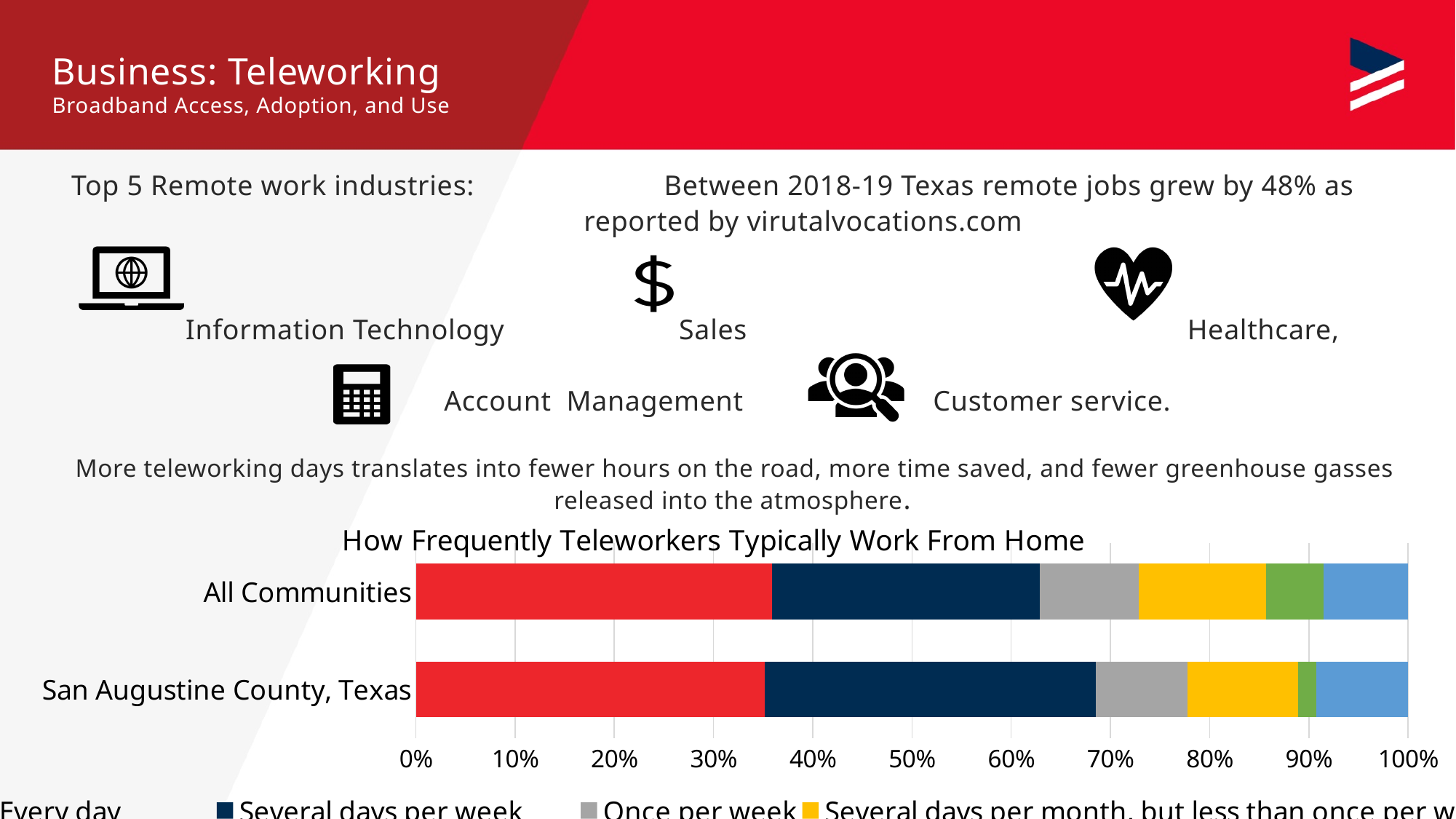
How many communities (categories) are plotted in the "How Frequently Teleworkers Typically Work From Home" chart? 2 In the "How Frequently Teleworkers Typically Work From Home" chart, which frequency category makes up the largest share for All Communities? Every day In the "How Frequently Teleworkers Typically Work From Home" chart, is the "Every day" share for All Communities greater or less than 30%? greater In the "How Frequently Teleworkers Typically Work From Home" chart, is the combined share of "Every day" and "Several days per week" for San Augustine County, Texas greater or less than 60%? greater What kind of chart is "How Frequently Teleworkers Typically Work From Home"? Stacked bar chart In the "How Frequently Teleworkers Typically Work From Home" chart, is the "Every day" share for San Augustine County, Texas greater or less than 30%? greater In the "How Frequently Teleworkers Typically Work From Home" chart, what colour represents "Every day"? Red What is the maximum value shown on the x axis of the "How Frequently Teleworkers Typically Work From Home" chart? 100% What is the title of the chart at the bottom of the slide? How Frequently Teleworkers Typically Work From Home In the "How Frequently Teleworkers Typically Work From Home" chart, which community has the larger green segment? All Communities In the "How Frequently Teleworkers Typically Work From Home" chart, which has the larger "Several days per week" share, All Communities or San Augustine County, Texas? San Augustine County, Texas